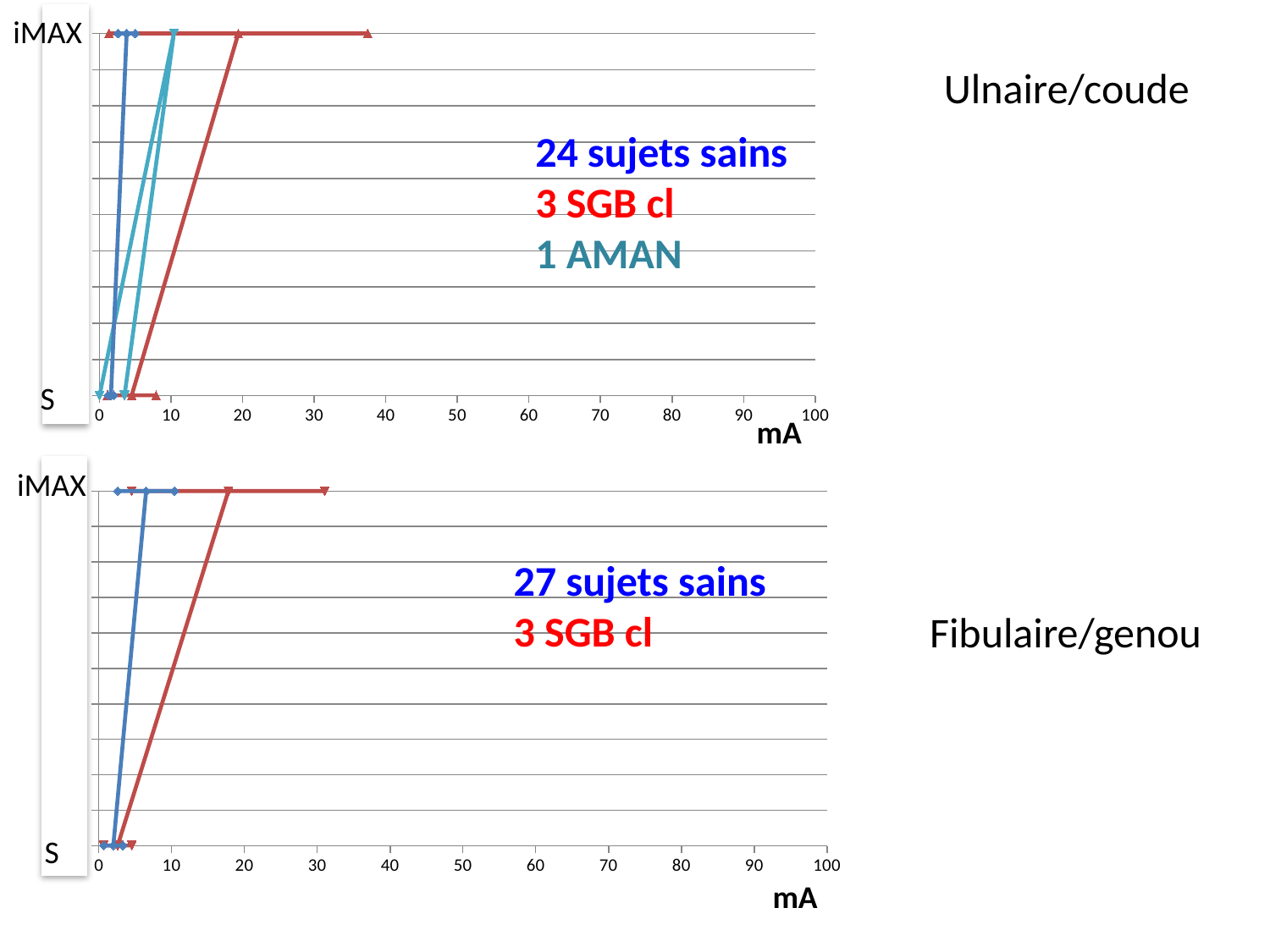
In the bottom chart (Fibulaire/genou), is the highest iMAX value for the sujets sains group greater or less than 20 mA? less What unit is shown on the x axis of both charts? mA In the bottom chart (Fibulaire/genou), how many groups are listed in the legend? 2 In the top chart (Ulnaire/coude), how many groups are listed in the legend? 3 In the top chart (Ulnaire/coude), which group reaches the highest mA value at iMAX, sujets sains or SGB cl? SGB cl In the bottom chart (Fibulaire/genou), how many healthy subjects (sujets sains) are indicated? 27 In the top chart (Ulnaire/coude), is the highest iMAX value for the SGB cl group greater or less than 30 mA? greater In the bottom chart (Fibulaire/genou), is the highest iMAX value for the SGB cl group greater or less than 40 mA? less What kind of chart is the top chart (Ulnaire/coude)? line chart In the bottom chart (Fibulaire/genou), which group reaches the highest mA value at iMAX, sujets sains or SGB cl? SGB cl In the top chart (Ulnaire/coude), what is the maximum value shown on the x axis? 100 In the top chart (Ulnaire/coude), how many healthy subjects (sujets sains) are indicated? 24